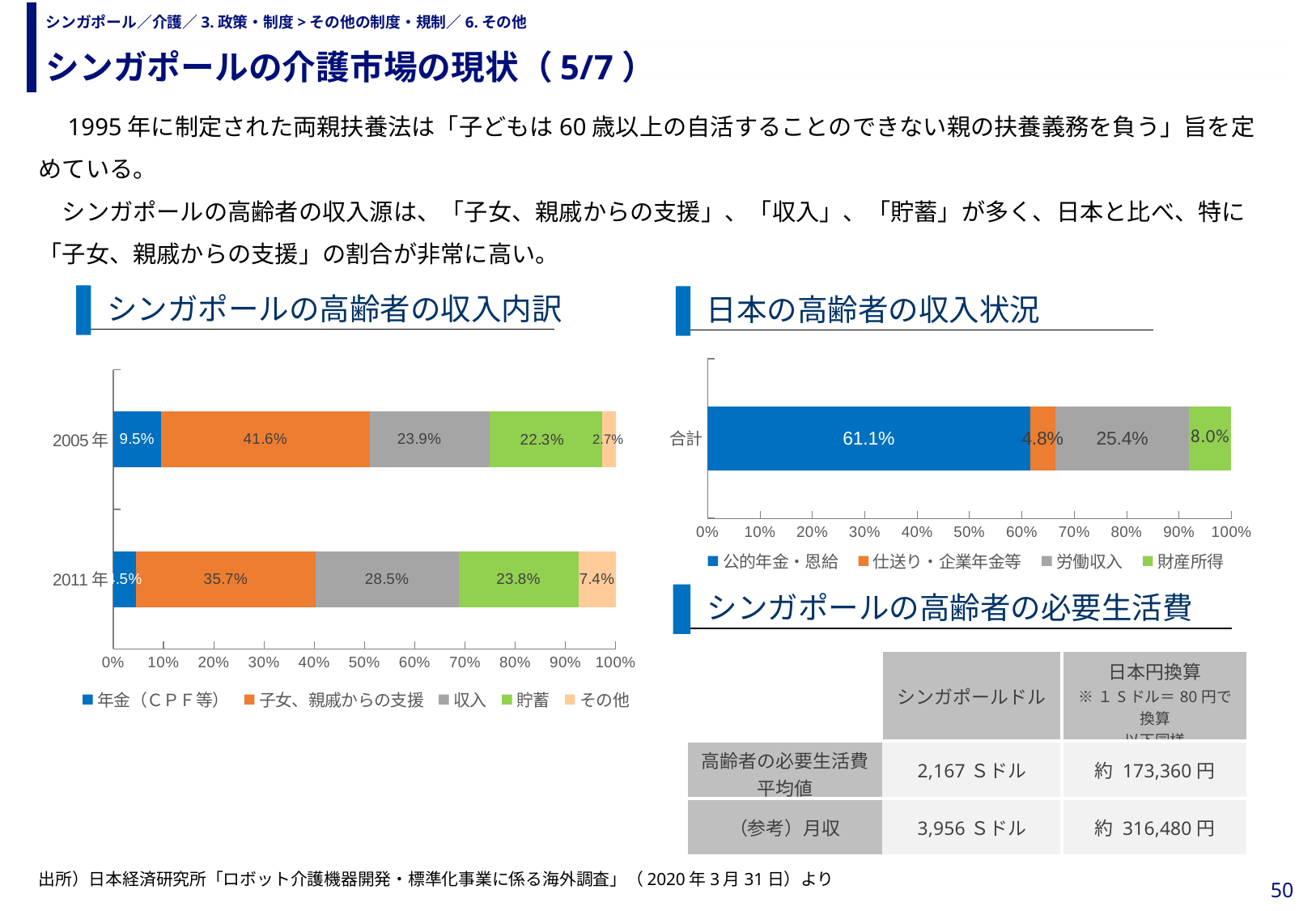
「日本の高齢者の収入状況」のグラフで、「労働収入」の値はいくつですか？ 25.4% 「シンガポールの高齢者の収入内訳」のグラフの凡例には、いくつの系列がありますか？ 5 「シンガポールの高齢者の収入内訳」のグラフで、2005年と2011年の「子女、親戚からの支援」の差はいくつですか？ 5.9% 「日本の高齢者の収入状況」のグラフで、「公的年金・恩給」の値はいくつですか？ 61.1% 「シンガポールの高齢者の収入内訳」のグラフで、2011年の「収入」の値はいくつですか？ 28.5% 「シンガポールの高齢者の収入内訳」のグラフで、2005年の「年金（ＣＰＦ等）」の値はいくつですか？ 9.5% 「シンガポールの高齢者の収入内訳」のグラフで、2005年の「貯蓄」と2011年の「貯蓄」ではどちらが大きいですか？ 2011年 「日本の高齢者の収入状況」のグラフで、「財産所得」と「仕送り・企業年金等」の差はいくつですか？ 3.2% 「シンガポールの高齢者の収入内訳」のグラフで、2005年の「子女、親戚からの支援」の値はいくつですか？ 41.6% 「シンガポールの高齢者の収入内訳」のグラフで、2011年の「その他」の値はいくつですか？ 7.4% 「シンガポールの高齢者の収入内訳」のグラフは、どの種類のグラフですか？ 積み上げ棒グラフ 「日本の高齢者の収入状況」のグラフで、最も小さい系列はどれですか？ 仕送り・企業年金等